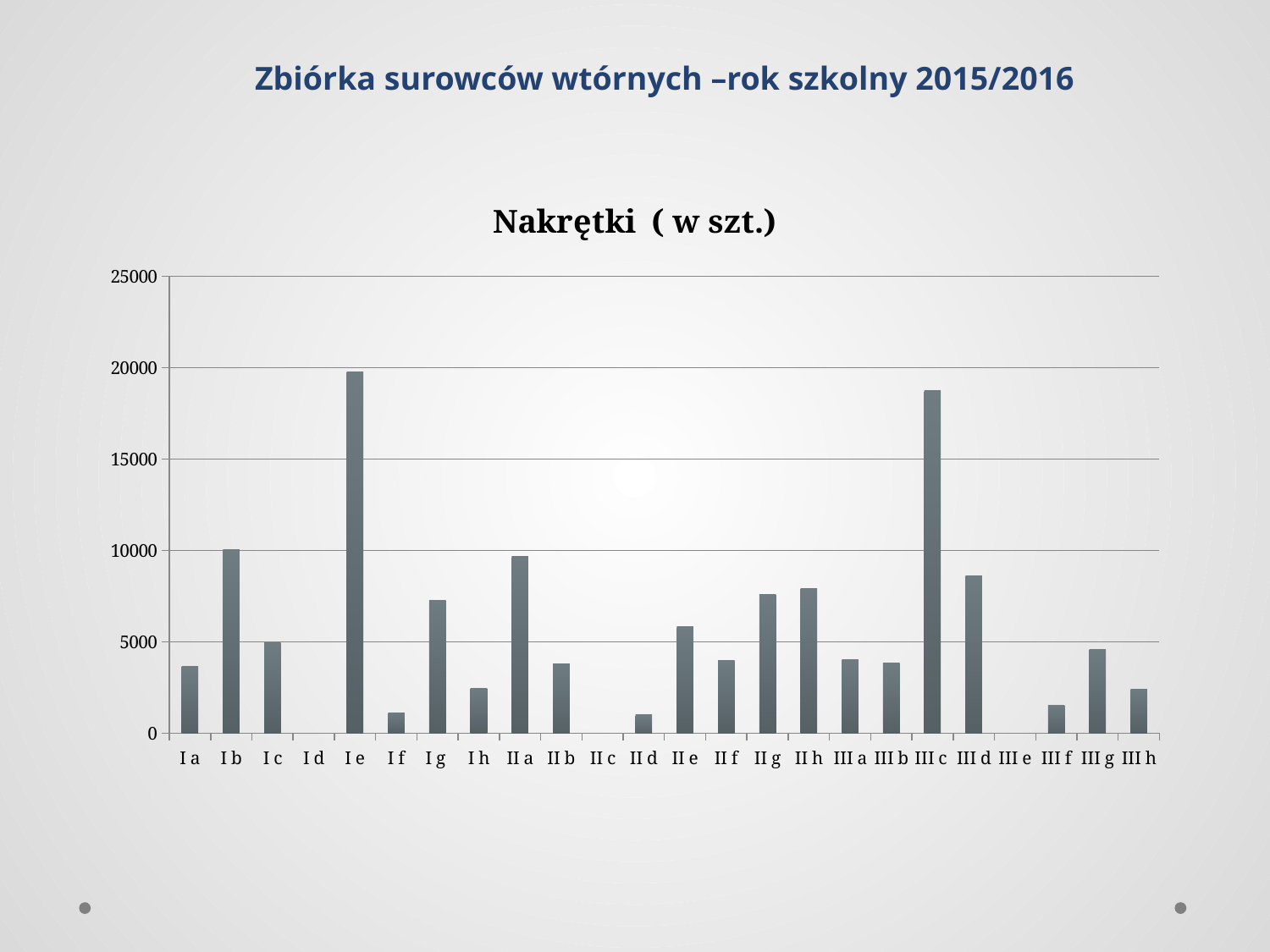
Which is larger, the value for I e or the value for III c? I e Is the value for I e greater or less than 15000? greater Is the value for III c greater or less than 15000? greater Which is larger, the value for I b or the value for I c? I b What is the title of the chart? Nakrętki ( w szt.) Is the value for I f greater or less than 5000? less How many categories (classes) are shown on the x axis of the chart? 24 Which is larger, the value for III d or the value for III g? III d Which class has the highest value in the chart? I e What kind of chart is shown on the slide? bar chart